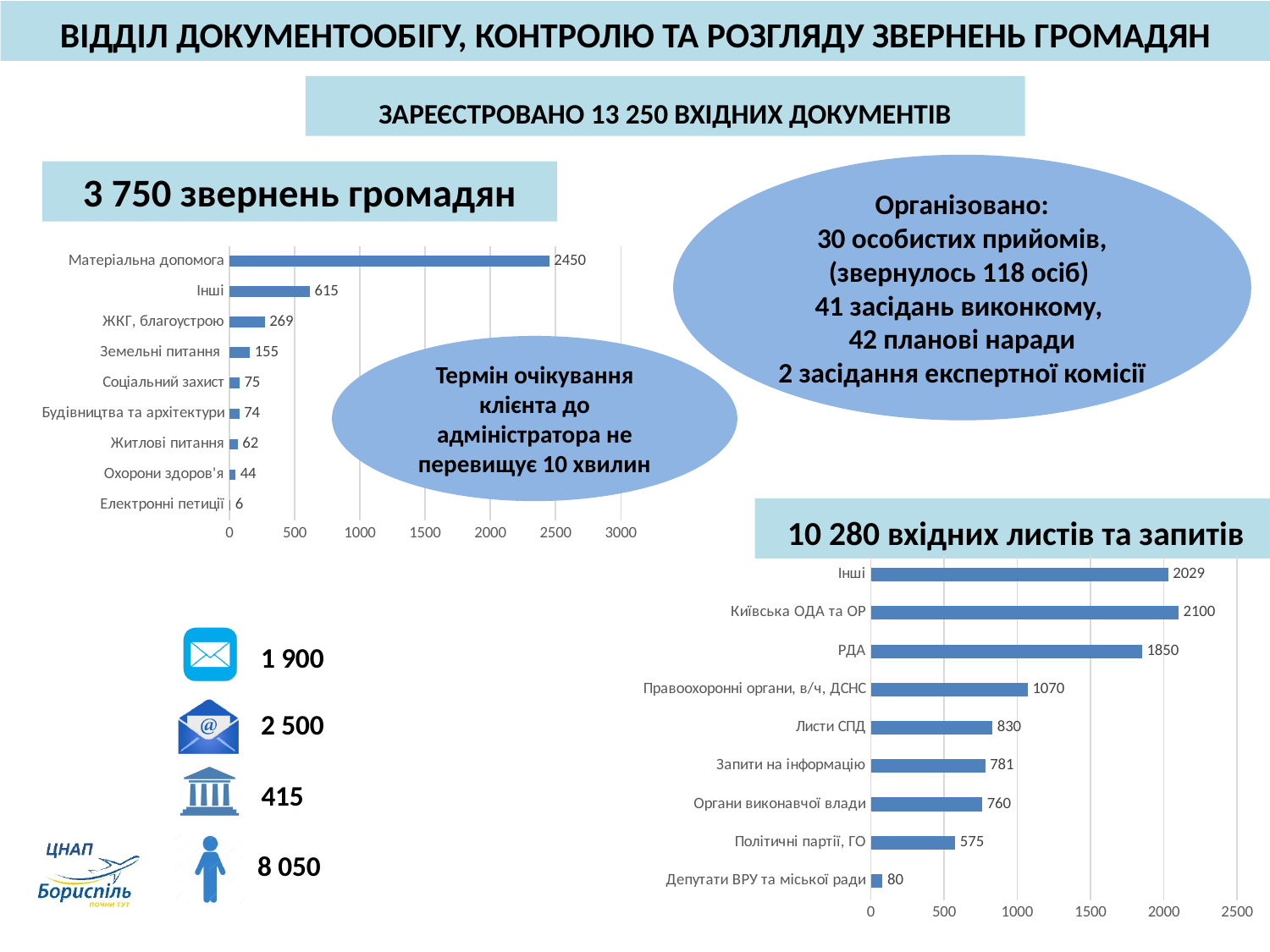
In the chart titled "3 750 звернень громадян", which category has the lowest value? Електронні петиції In the chart titled "3 750 звернень громадян", what is the value for "Матеріальна допомога"? 2450 In the chart titled "10 280 вхідних листів та запитів", which category has the highest value? Київська ОДА та ОР In the chart titled "3 750 звернень громадян", what is the value for "Охорони здоров'я"? 44 In the chart titled "10 280 вхідних листів та запитів", what is the value for "Листи СПД"? 830 What kind of chart is the one titled "10 280 вхідних листів та запитів"? Bar chart In the chart titled "10 280 вхідних листів та запитів", what is the difference between the values for "Інші" and "Депутати ВРУ та міської ради"? 1949 In the chart titled "10 280 вхідних листів та запитів", what is the value for "Політичні партії, ГО"? 575 In the chart titled "10 280 вхідних листів та запитів", which is larger: the value for "РДА" or the value for "Правоохоронні органи, в/ч, ДСНС"? РДА In the chart titled "10 280 вхідних листів та запитів", which category has the lowest value? Депутати ВРУ та міської ради In the chart titled "3 750 звернень громадян", how many categories are plotted? 9 In the chart titled "3 750 звернень громадян", what is the difference between the values for "Інші" and "ЖКГ, благоустрою"? 346